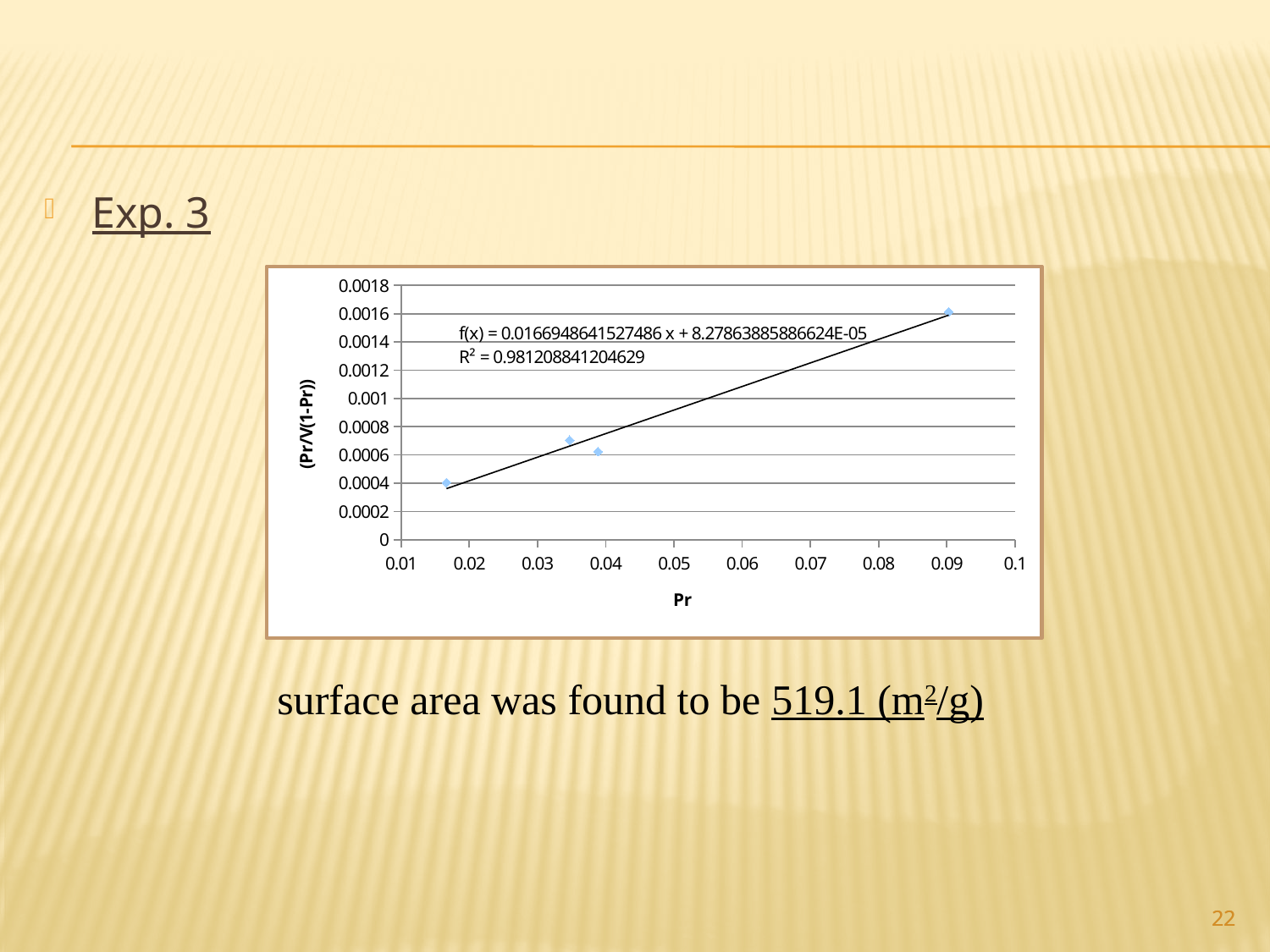
Which data point has the highest (Pr/V(1-Pr)) value, the leftmost or the rightmost? rightmost How many data points are plotted on the chart? 4 What R² value is printed on the chart? R² = 0.981208841204629 What kind of chart is shown on the slide? scatter chart What is the maximum value shown on the y axis of the chart? 0.0018 Is the value of the data point near Pr = 0.035 greater or less than 0.001? less What is the title of the x axis of the chart? Pr Which is larger, the value of the leftmost data point or the value of the rightmost data point? rightmost Do the plotted values rise or fall as Pr increases along the x axis? rise Is the value of the leftmost data point (near Pr = 0.02) greater or less than 0.0006? less Which data point has the lowest (Pr/V(1-Pr)) value, the leftmost or the rightmost? leftmost Is the value of the rightmost data point (near Pr = 0.09) greater or less than 0.0014? greater